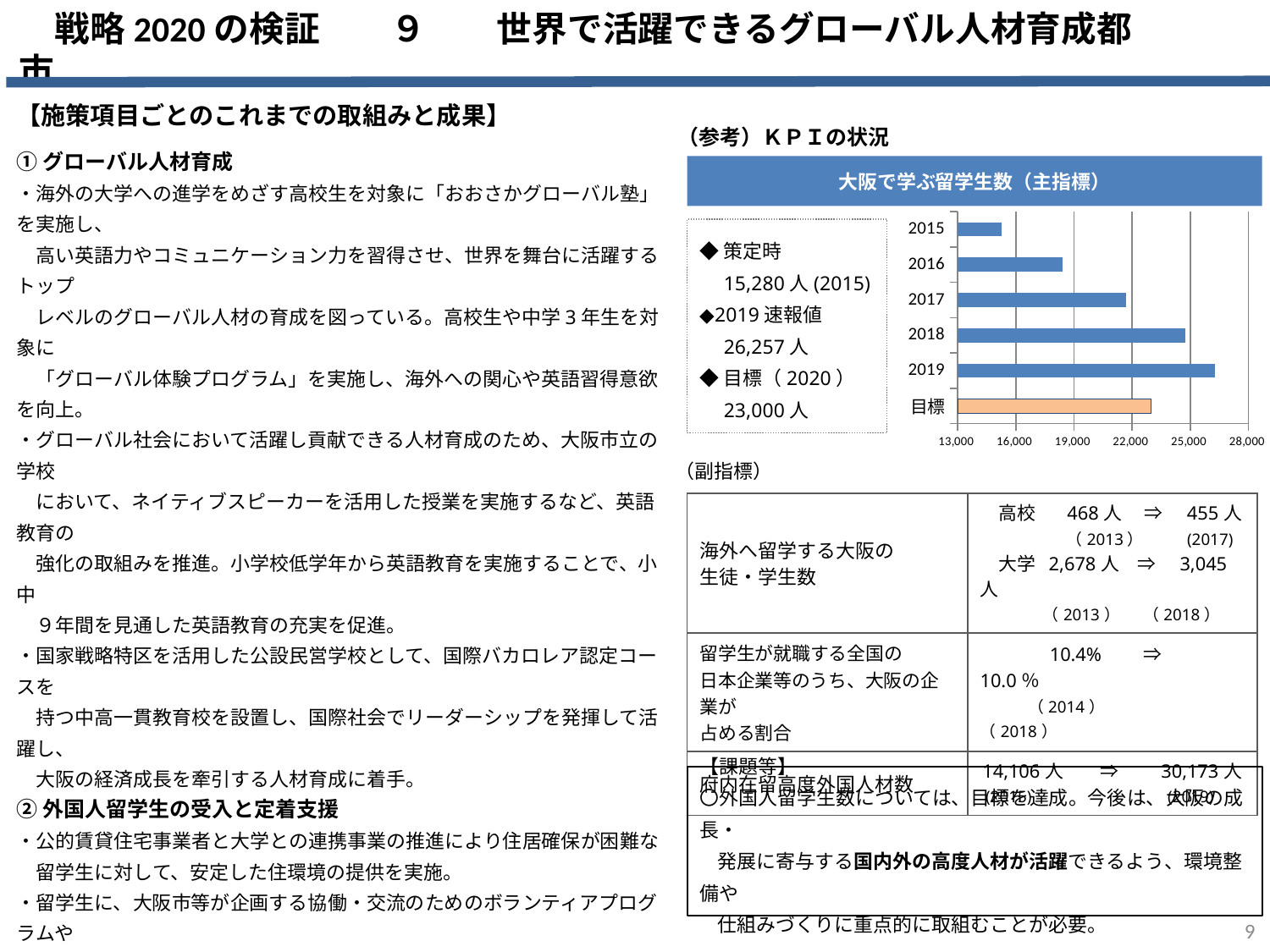
By how much does the 2019 value exceed the 目標 value in the 大阪で学ぶ留学生数 chart? 3,257 人 What is the 目標 (2020) value for 大阪で学ぶ留学生数? 23,000 人 What is the 2019 速報値 for 大阪で学ぶ留学生数? 26,257 人 Do the values in the 大阪で学ぶ留学生数 chart rise or fall from 2015 to 2019? rise Is the 2019 value or the 目標 value larger in the 大阪で学ぶ留学生数 chart? 2019 How many bars does the 大阪で学ぶ留学生数 chart show? 6 Which year has the shortest bar in the 大阪で学ぶ留学生数 chart? 2015 Which year has the longest bar in the 大阪で学ぶ留学生数 chart? 2019 What kind of chart is shown under 大阪で学ぶ留学生数（主指標）? bar chart In the 大阪で学ぶ留学生数 chart, is the value for 2017 greater or less than 19,000? greater According to the slide, what was the number of international students studying in Osaka in 2015 (策定時)? 15,280 人 In the 大阪で学ぶ留学生数 chart, is the value for 2016 greater or less than 19,000? less